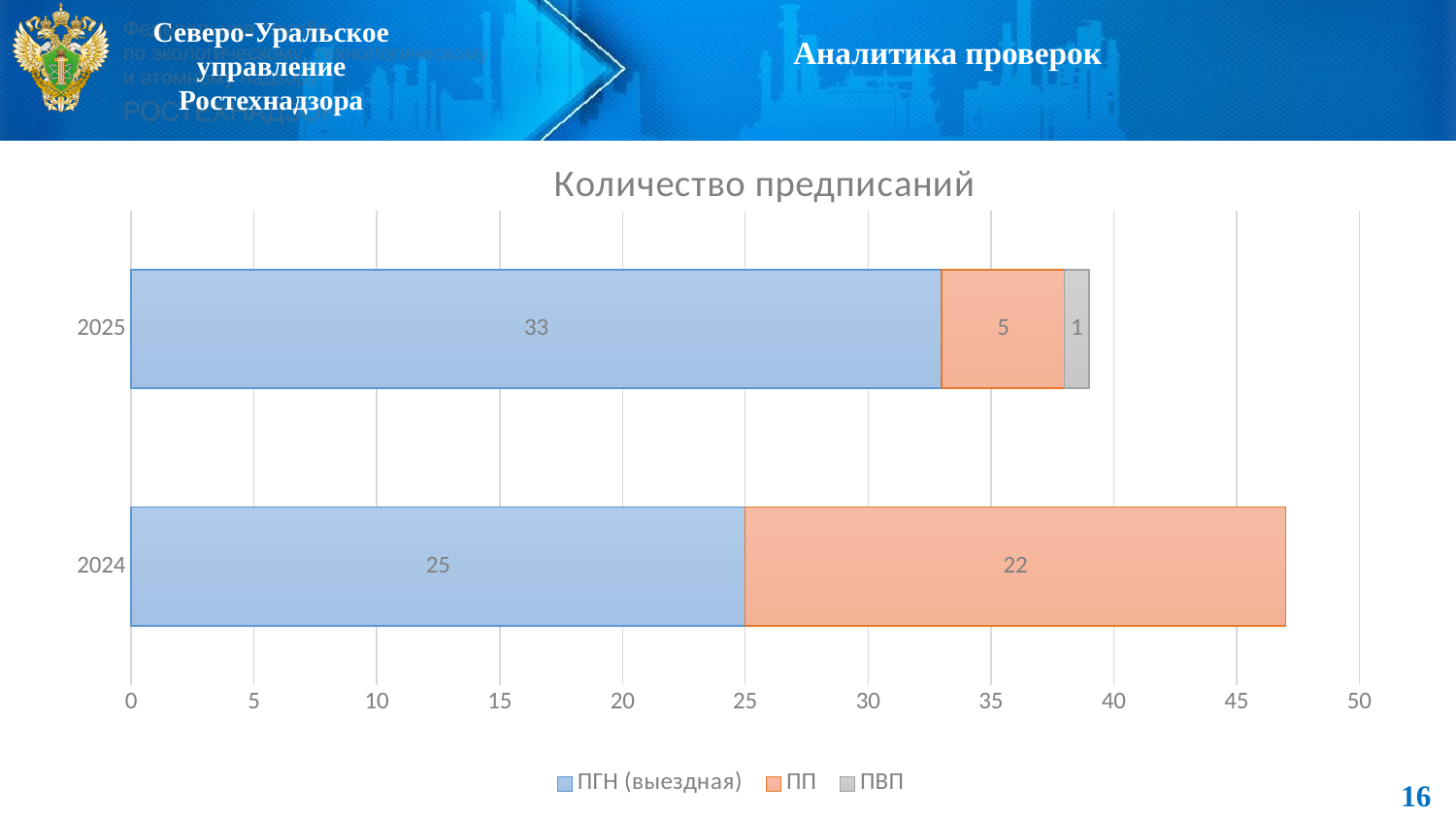
What is the value of ПП for 2025? 5 What is the total of the stacked bar for 2024? 47 What is the total of the stacked bar for 2025? 39 Which year has the larger ПП value, 2024 or 2025? 2024 How many categories (years) are shown on the chart? 2 What is the title of the chart? Количество предписаний What is the value of ПВП for 2025? 1 What is the value of ПП for 2024? 22 What is the value of ПГН (выездная) for 2025? 33 What kind of chart is shown on the slide? Stacked bar chart What is the difference between the ПГН (выездная) values for 2025 and 2024? 8 How many series does the legend list? 3